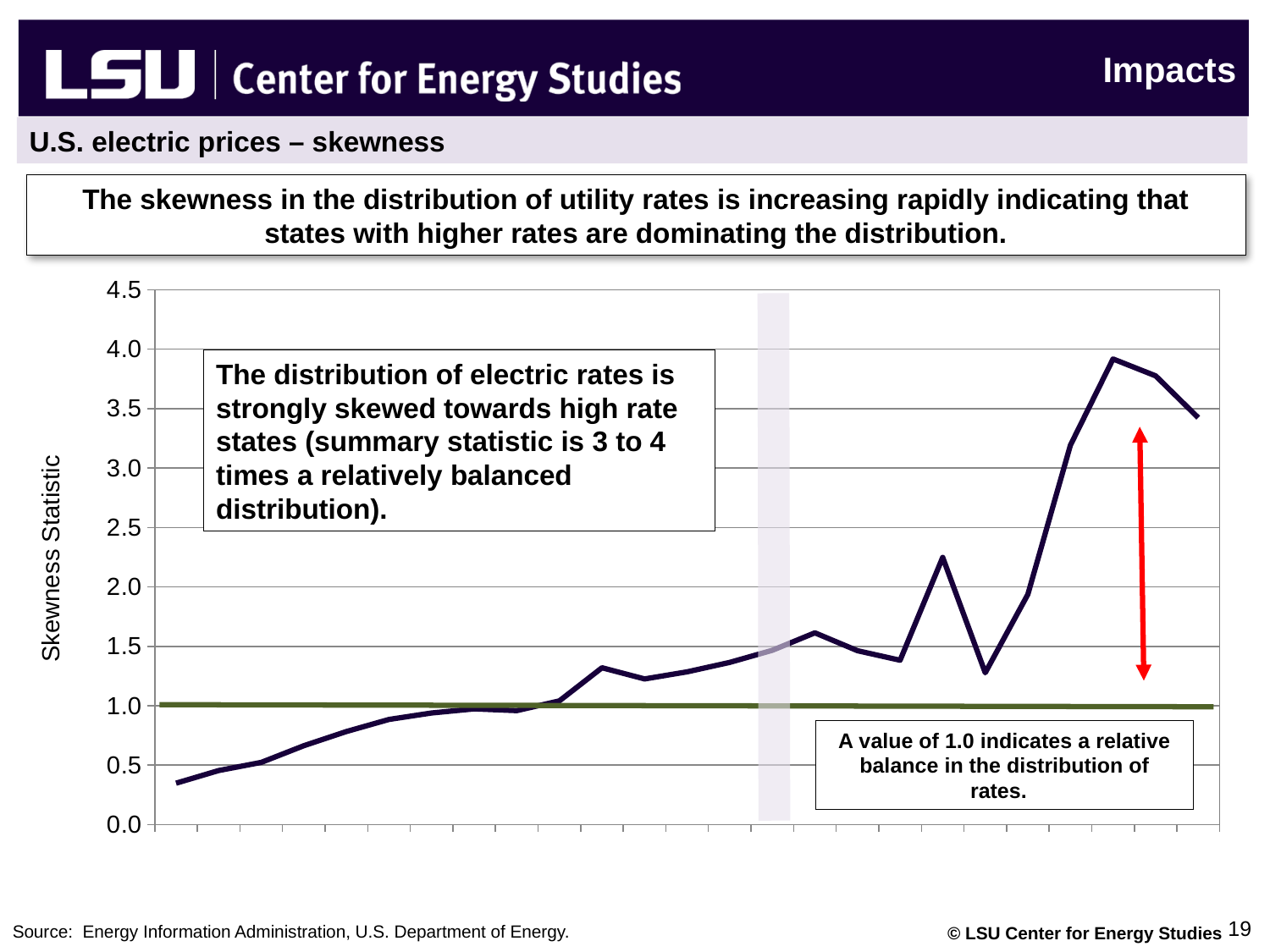
What is the label on the y axis of the chart? Skewness Statistic Is the highest point of the skewness line greater or less than 3.5? greater At what value is the horizontal reference line drawn on the chart? 1.0 Is the rightmost value of the skewness line greater or less than the 1.0 reference line? greater Is the first (leftmost) value of the skewness line greater or less than 0.5? less What kind of chart is shown on the slide? line chart Overall, does the skewness statistic rise or fall from left to right along the x axis? rise What is the maximum value shown on the y axis? 4.5